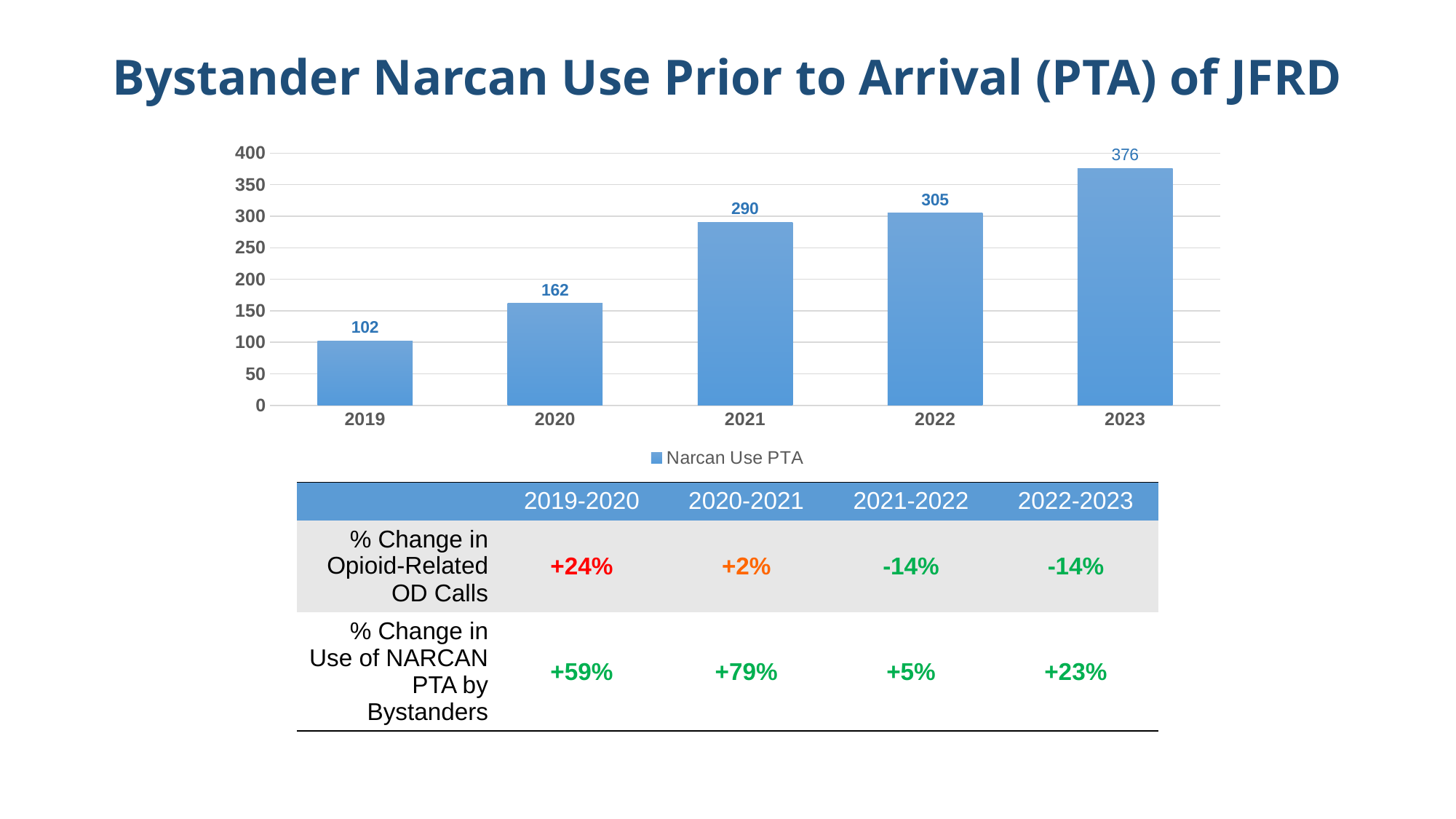
What is the Narcan Use PTA value for 2023? 376 What is the difference between the Narcan Use PTA values for 2020 and 2019? 60 Which year has a larger Narcan Use PTA value, 2020 or 2022? 2022 Which year has the highest Narcan Use PTA value? 2023 Do the Narcan Use PTA values rise or fall from 2019 to 2023? Rise Which year has the lowest Narcan Use PTA value? 2019 What is the Narcan Use PTA value for 2019? 102 How many years are shown on the x axis of the chart? 5 What is the Narcan Use PTA value for 2021? 290 What is the difference between the Narcan Use PTA values for 2023 and 2022? 71 Is the Narcan Use PTA value for 2022 greater or less than 250? greater What kind of chart is shown on the slide? Bar chart